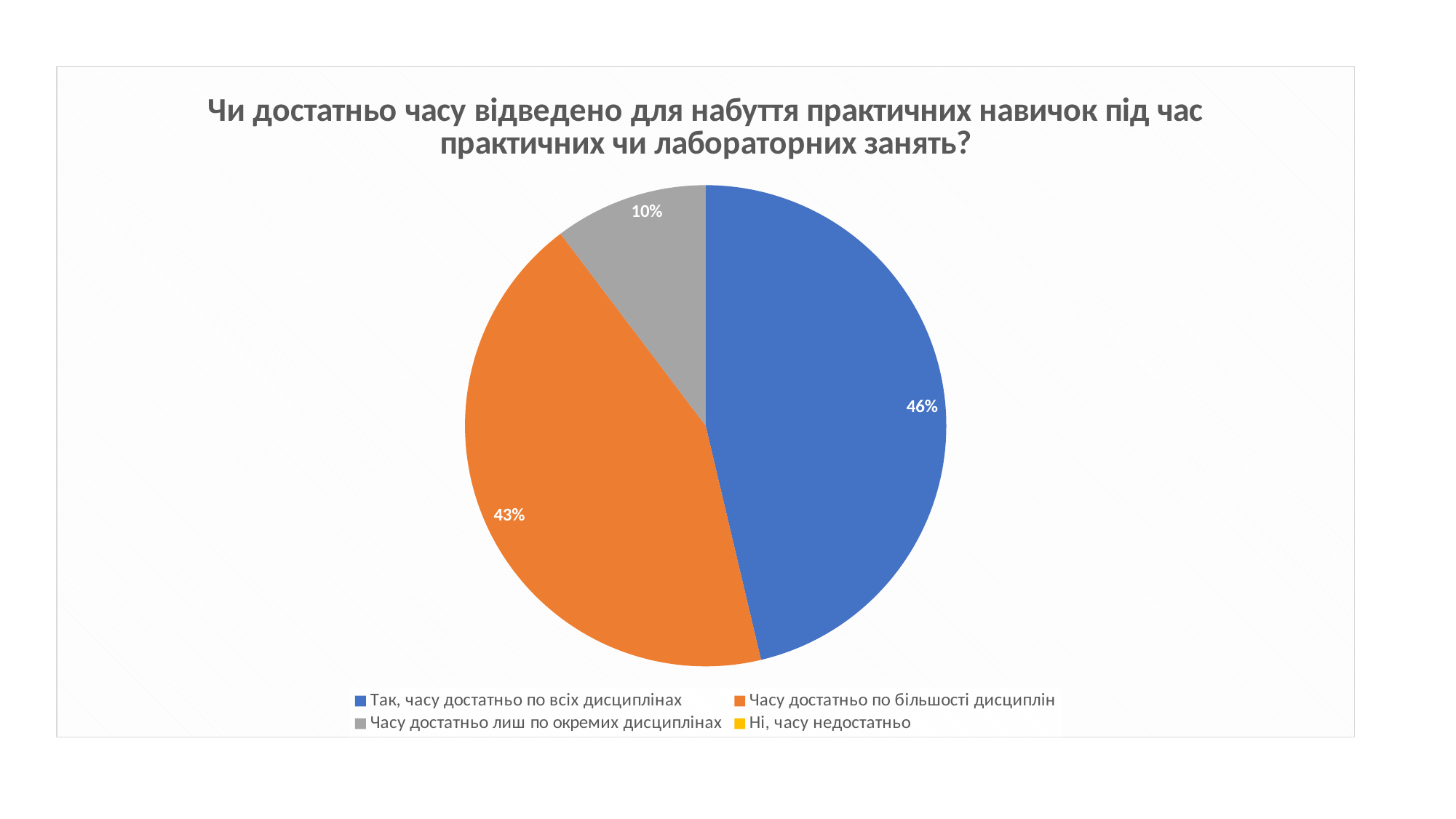
Which of the labelled slices is the smallest? Часу достатньо лиш по окремих дисциплінах How many categories are listed in the legend? 4 Which category has the largest slice of the pie? Так, часу достатньо по всіх дисциплінах What percentage is shown for the slice "Часу достатньо по більшості дисциплін"? 43% What kind of chart is shown on the slide? Pie chart How many slices with data labels are visible in the pie? 3 By how many percentage points does "Так, часу достатньо по всіх дисциплінах" exceed "Часу достатньо по більшості дисциплін"? 3 percentage points What colour is the slice for "Часу достатньо по більшості дисциплін"? Orange What percentage is shown for the slice "Так, часу достатньо по всіх дисциплінах"? 46% Which legend entry has no visible slice in the pie? Ні, часу недостатньо What percentage is shown for the slice "Часу достатньо лиш по окремих дисциплінах"? 10% Which is larger: the slice for "Часу достатньо по більшості дисциплін" or the slice for "Часу достатньо лиш по окремих дисциплінах"? Часу достатньо по більшості дисциплін